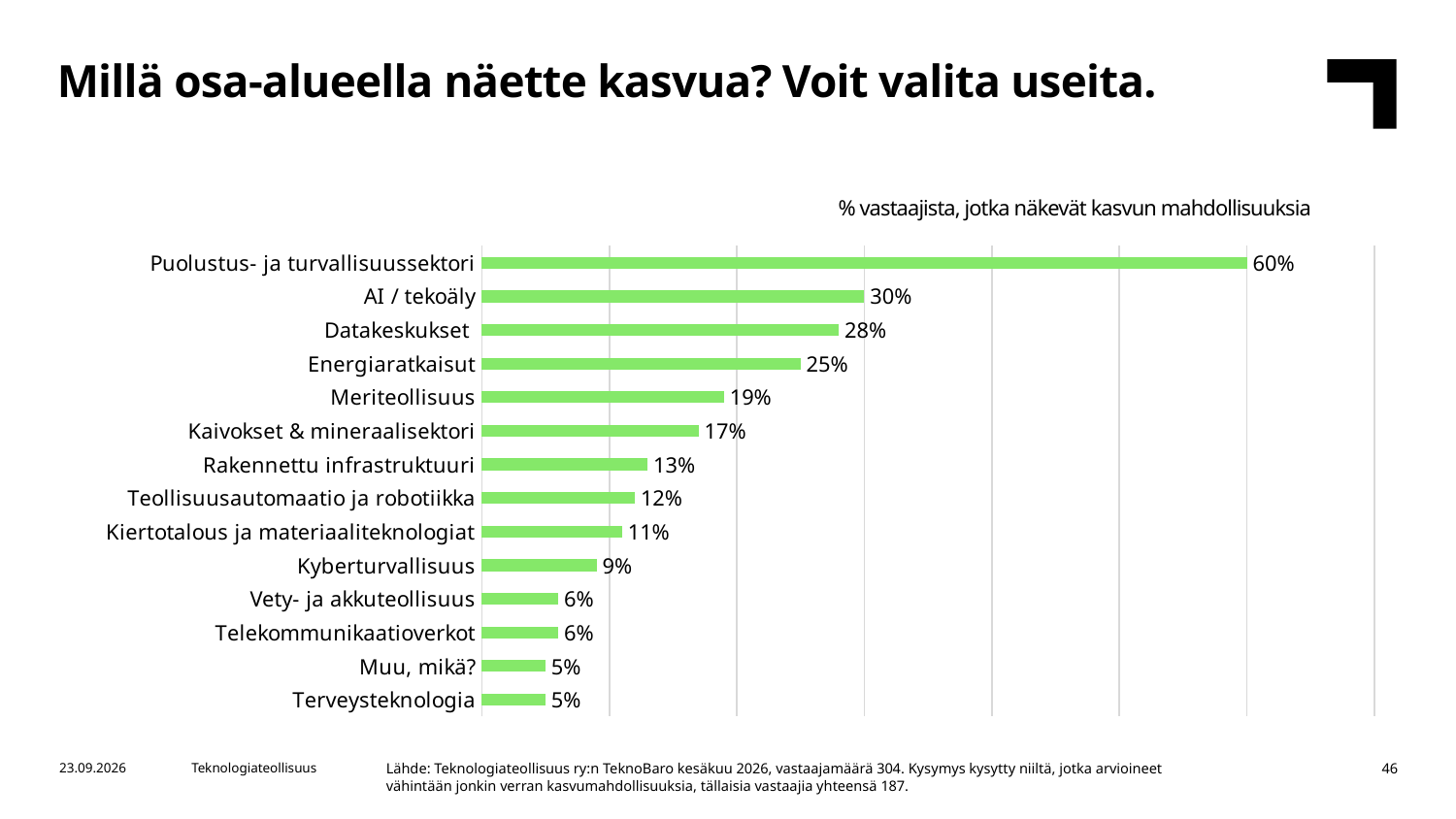
What is the difference between the values for Datakeskukset and Energiaratkaisut? 3% What is the difference between the values for Puolustus- ja turvallisuussektori and AI / tekoäly? 30% What is the subtitle text shown above the chart? % vastaajista, jotka näkevät kasvun mahdollisuuksia What is the value shown for Meriteollisuus? 19% What percentage of respondents see growth in Puolustus- ja turvallisuussektori? 60% What is the value shown for Kyberturvallisuus? 9% Which category has the lowest value in the chart? Terveysteknologia and Muu, mikä? (both 5%) What is the value shown for AI / tekoäly? 30% What type of chart is shown on the slide? Bar chart Which has a larger value, Kaivokset & mineraalisektori or Rakennettu infrastruktuuri? Kaivokset & mineraalisektori Which category has the highest value in the chart? Puolustus- ja turvallisuussektori How many categories are shown in the chart? 14